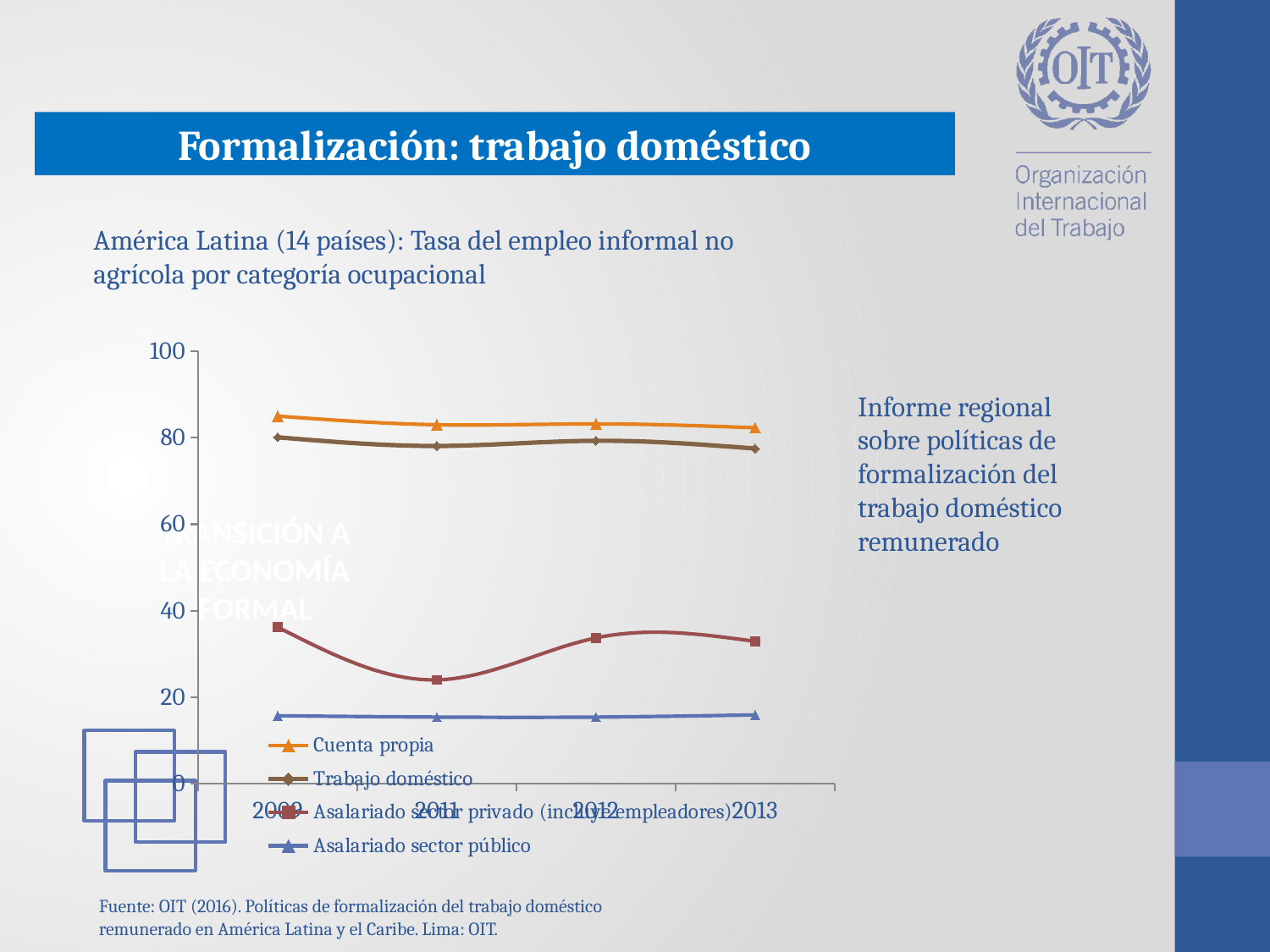
In 2012, which is larger: Trabajo doméstico or Asalariado sector privado (incluye empleadores)? Trabajo doméstico How many series does the legend list? 4 Is the value for Asalariado sector privado (incluye empleadores) in 2011 greater or less than 40? less Is the value for Trabajo doméstico in 2011 greater or less than 60? greater What colour is the Cuenta propia line in the legend? Orange Which series has the lowest values across all years? Asalariado sector público Is the value for Cuenta propia in 2013 greater or less than 80? greater Does the Cuenta propia line rise or fall from the first year to 2013? Fall Which series has the highest values across all years? Cuenta propia What kind of chart is shown on the slide? Line chart How many years are plotted along the x axis? 4